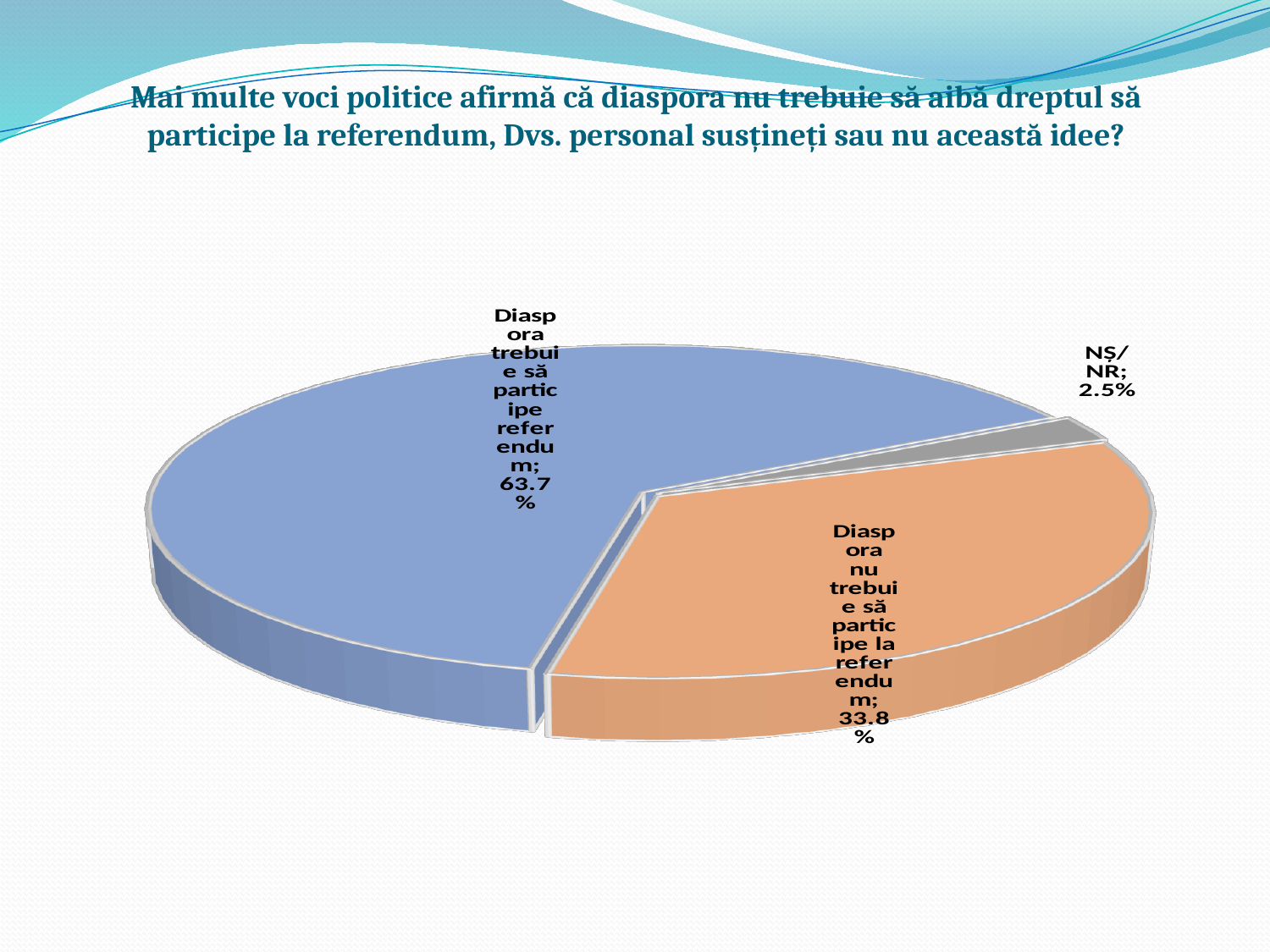
What is the difference in percentage points between the "Diaspora nu trebuie să participe la referendum" slice and the "NȘ/NR" slice? 31.3 How many slices does the pie chart have? 3 What colour is the largest slice of the pie? blue Which slice of the pie is the smallest? NȘ/NR What share of the pie is labelled "NȘ/NR"? 2.5% What colour is the slice labelled "Diaspora nu trebuie să participe la referendum"? orange Which is larger: the "Diaspora nu trebuie să participe la referendum" slice or the "NȘ/NR" slice? Diaspora nu trebuie să participe la referendum What share of the pie is labelled "Diaspora nu trebuie să participe la referendum"? 33.8% Which slice of the pie is the largest? Diaspora trebuie să participe referendum What kind of chart is shown on the slide? pie chart What share of the pie is labelled "Diaspora trebuie să participe referendum"? 63.7% What is the difference in percentage points between the "Diaspora trebuie să participe referendum" slice and the "Diaspora nu trebuie să participe la referendum" slice? 29.9